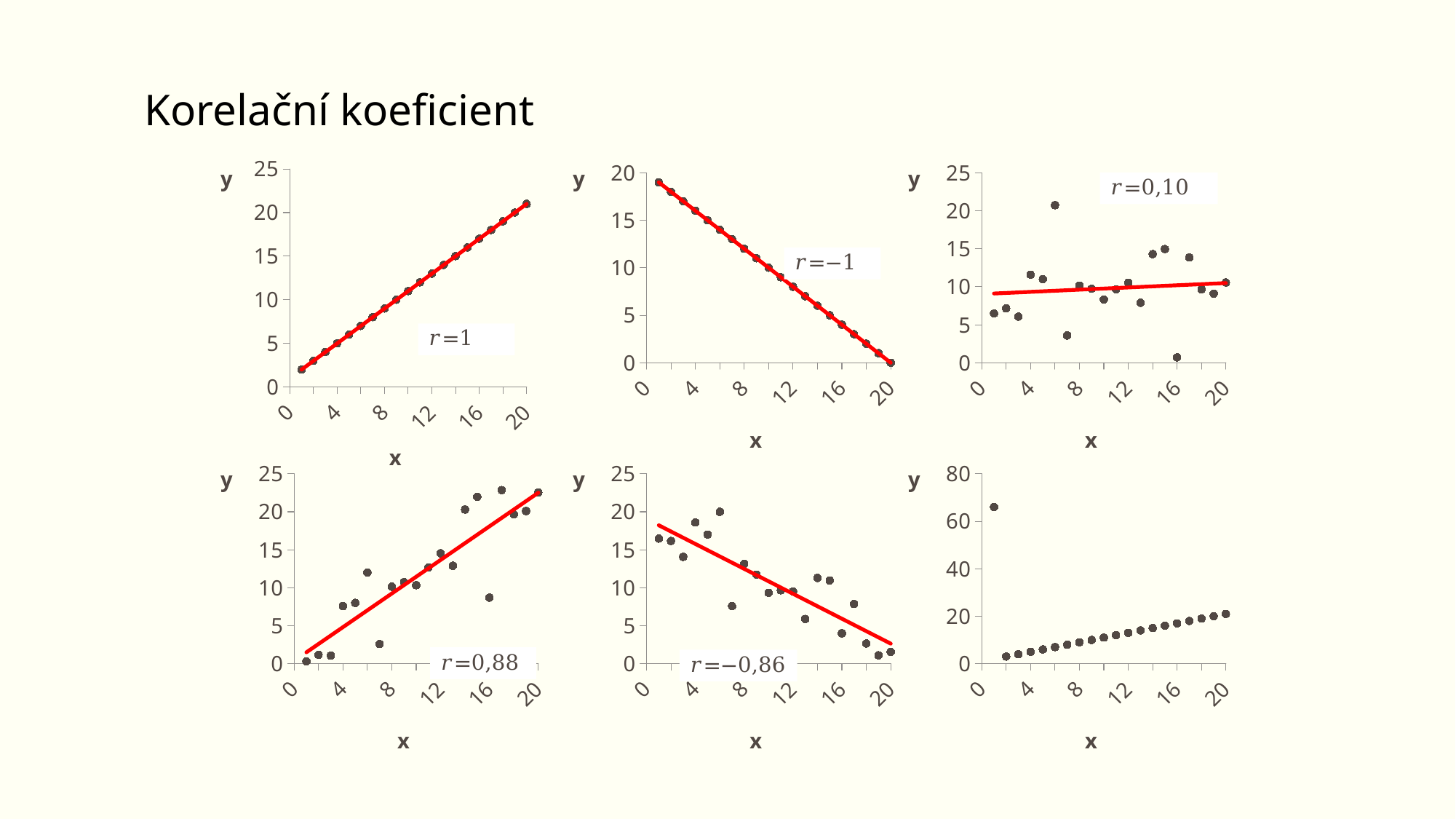
In the bottom-right chart, is the y value at x=1 greater or less than 60? greater In the bottom-left chart, do the y values generally rise or fall as x increases? rise In the bottom-middle chart, do the y values generally rise or fall as x increases? fall How many charts are shown on the slide? 6 In the top-middle chart labelled r=−1, do the y values rise or fall as x increases? fall What kind of chart is the top-left chart labelled r=1? scatter chart In the top-right chart labelled r=0,10, is the y value at x=16 greater or less than 5? less In the bottom-right chart, at which x value is the y value highest? x=1 What correlation coefficient is printed on the top-right chart? r=0,10 What correlation coefficient is printed on the bottom-left chart? r=0,88 In the top-right chart labelled r=0,10, is the y value at x=6 greater or less than 15? greater